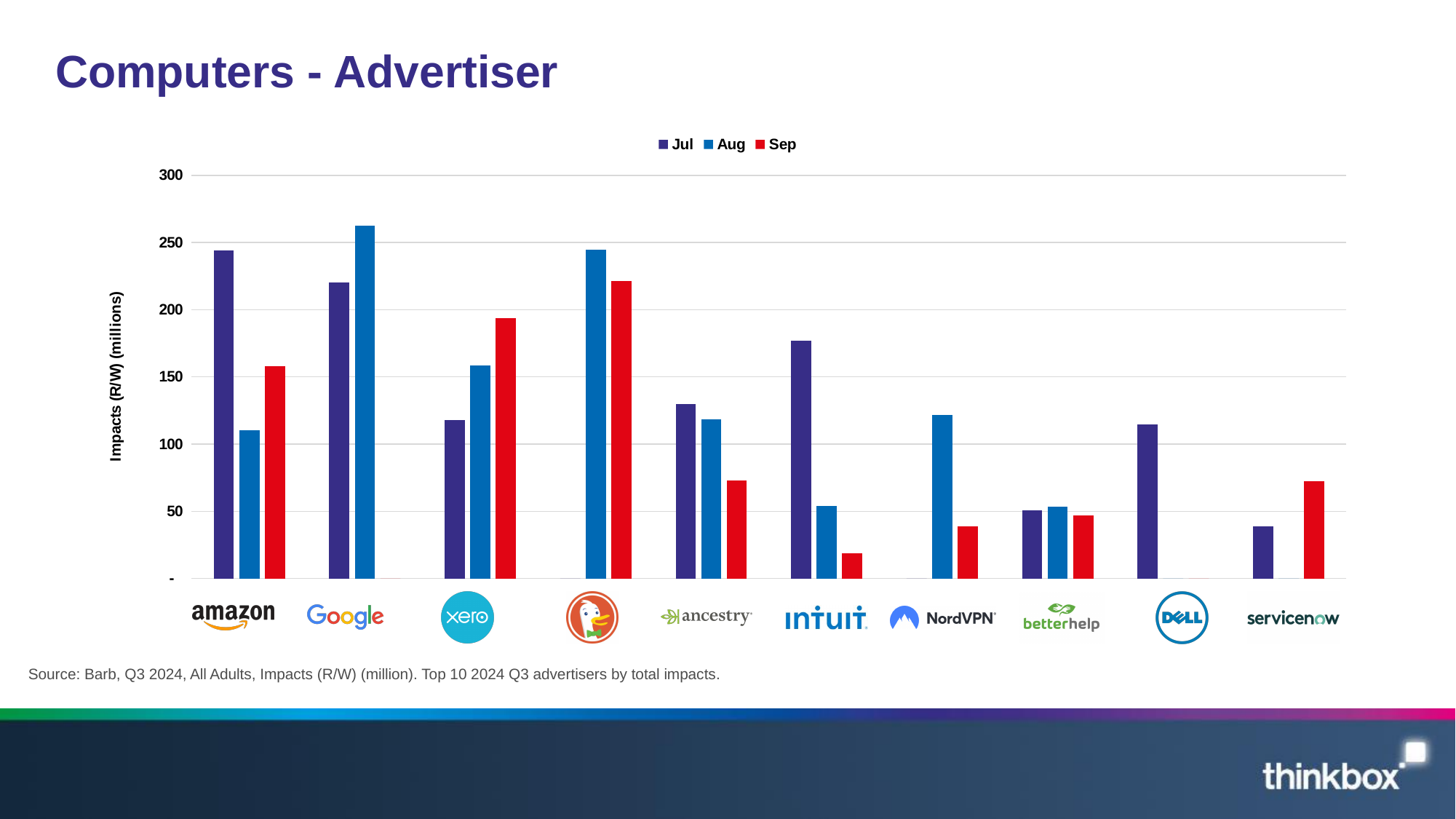
Do the values for Xero rise or fall from Jul to Sep? rise What kind of chart is shown on the slide? bar chart What is the label on the y axis? Impacts (R/W) (millions) How many advertisers are shown along the x axis? 10 How many series does the legend list? 3 Do the values for Intuit rise or fall from Jul to Sep? fall Which is larger: the Jul value for Amazon or the Jul value for Google? Amazon Which advertiser has the tallest bar on the chart? Google Is the Jul value for Dell greater or less than 100? greater Is the Aug value for Amazon greater or less than 150? less For Xero, which is larger: the Jul value or the Sep value? Sep Is the Jul value for Amazon greater or less than 200? greater